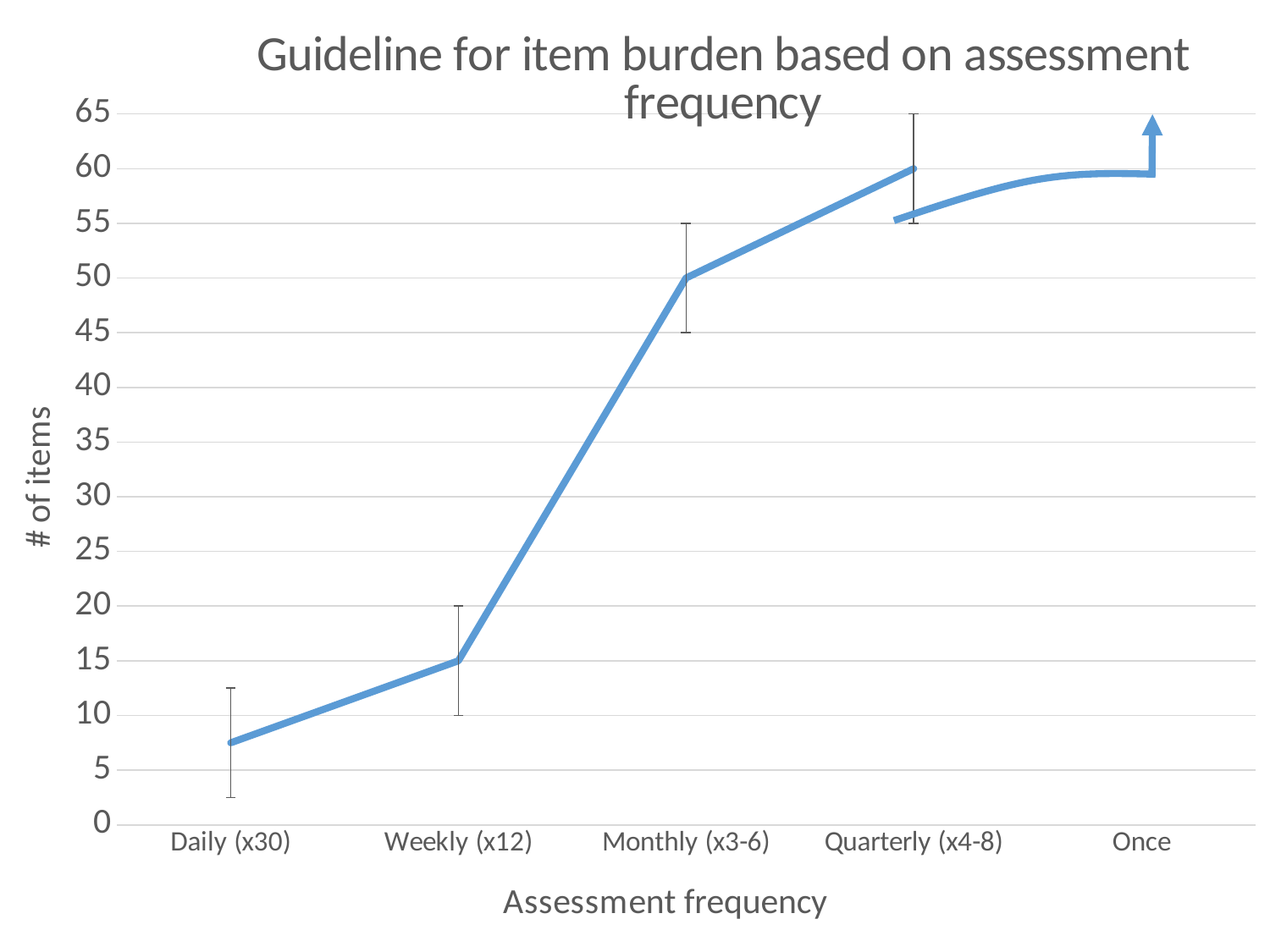
What is the title of the chart? Guideline for item burden based on assessment frequency Is the value for Monthly (x3-6) greater or less than 40? greater Which assessment frequency has the lowest # of items? Daily (x30) How many assessment frequency categories are shown on the x axis? 5 What is the # of items for Weekly (x12)? 15 What is the # of items for Monthly (x3-6)? 50 What is the difference in # of items between Monthly (x3-6) and Weekly (x12)? 35 Is the value for Daily (x30) greater or less than 10? less What kind of chart is shown on the slide? line chart Which has a higher # of items, Weekly (x12) or Monthly (x3-6)? Monthly (x3-6) Do the values rise or fall from Daily (x30) to Quarterly (x4-8)? rise What is the # of items for Quarterly (x4-8)? 60